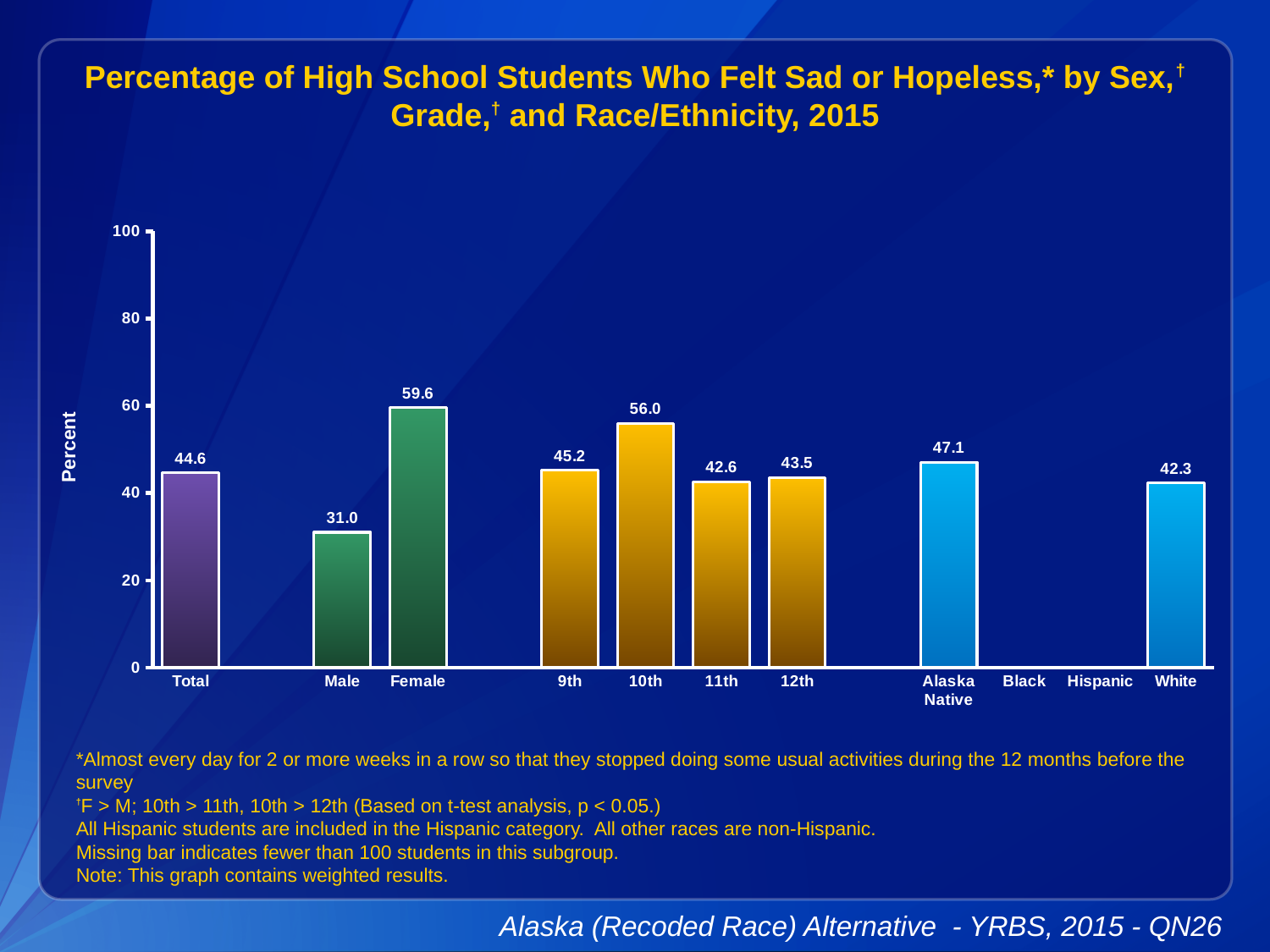
What is the value for 10th grade? 56.0 Which category has the highest value? Female How many bars are plotted on the chart? 9 What is the value for Male? 31.0 Which category has the lowest value? Male Is the value for Total greater or less than 40? greater Which is larger, the value for 9th grade or the value for 12th grade? 9th What is the label of the y axis? Percent What is the value for Alaska Native? 47.1 What kind of chart is shown? bar chart What is the difference between the Female and Male values? 28.6 What is the value for Female? 59.6